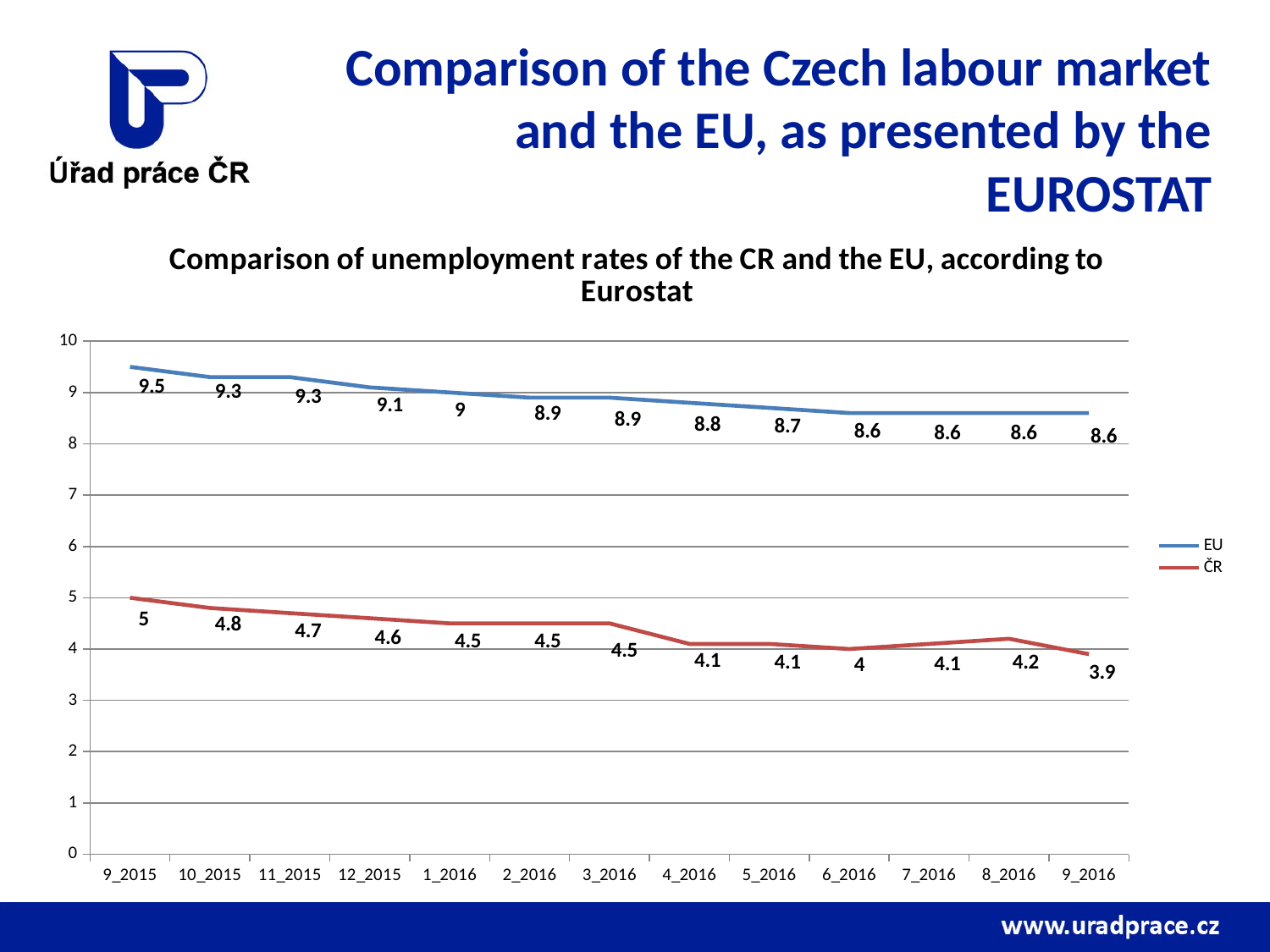
Which series has the higher value in 6_2016, EU or ČR? EU What is the ČR unemployment rate for 9_2016? 3.9 What kind of chart is this? line chart In which month is the EU unemployment rate highest? 9_2015 What is the EU unemployment rate for 9_2015? 9.5 What is the EU value for 1_2016? 9 How many series does the legend list? 2 What is the difference between the EU and ČR values for 9_2015? 4.5 What is the ČR value for 8_2016? 4.2 How many months are shown on the x axis? 13 Does the EU unemployment rate rise or fall from 9_2015 to 9_2016? fall In which month is the ČR unemployment rate lowest? 9_2016